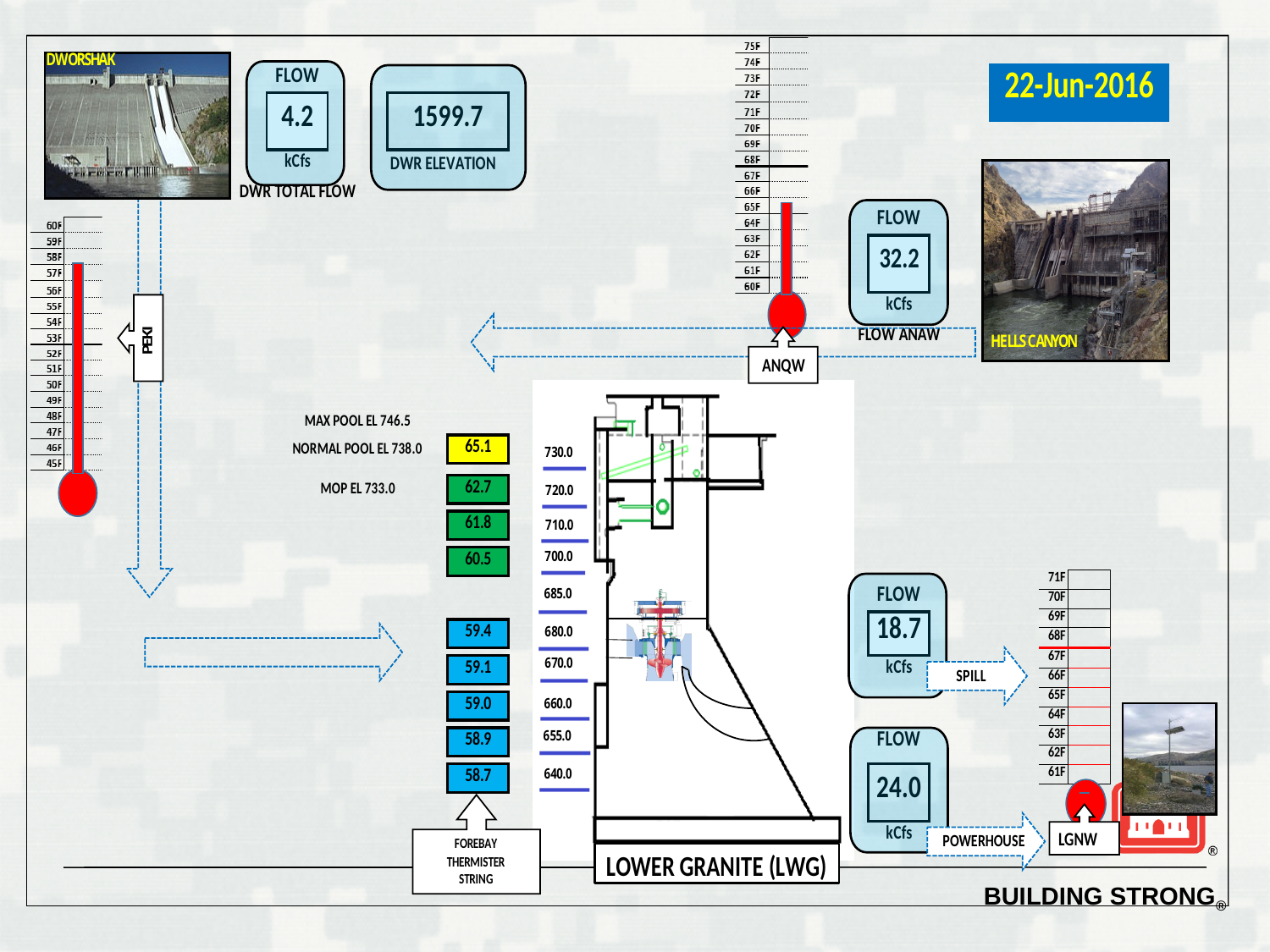
How many readings are shown on the Forebay Thermister String? 9 Is the temperature shown on the PEKI thermometer greater or less than 50F? greater What is the POWERHOUSE flow value shown for Lower Granite (LWG)? 24.0 kCfs What is the highest reading shown on the Forebay Thermister String? 65.1 What is the DWR ELEVATION value shown on the slide? 1599.7 What is the DWR TOTAL FLOW value shown for Dworshak? 4.2 kCfs What is the FLOW ANAW value shown next to Hells Canyon? 32.2 kCfs What is the lowest reading shown on the Forebay Thermister String? 58.7 What date is shown on the slide? 22-Jun-2016 What is the difference between the POWERHOUSE flow and the SPILL flow at Lower Granite? 5.3 kCfs What is the SPILL flow value shown for Lower Granite (LWG)? 18.7 kCfs Which is larger at Lower Granite, the SPILL flow or the POWERHOUSE flow? POWERHOUSE